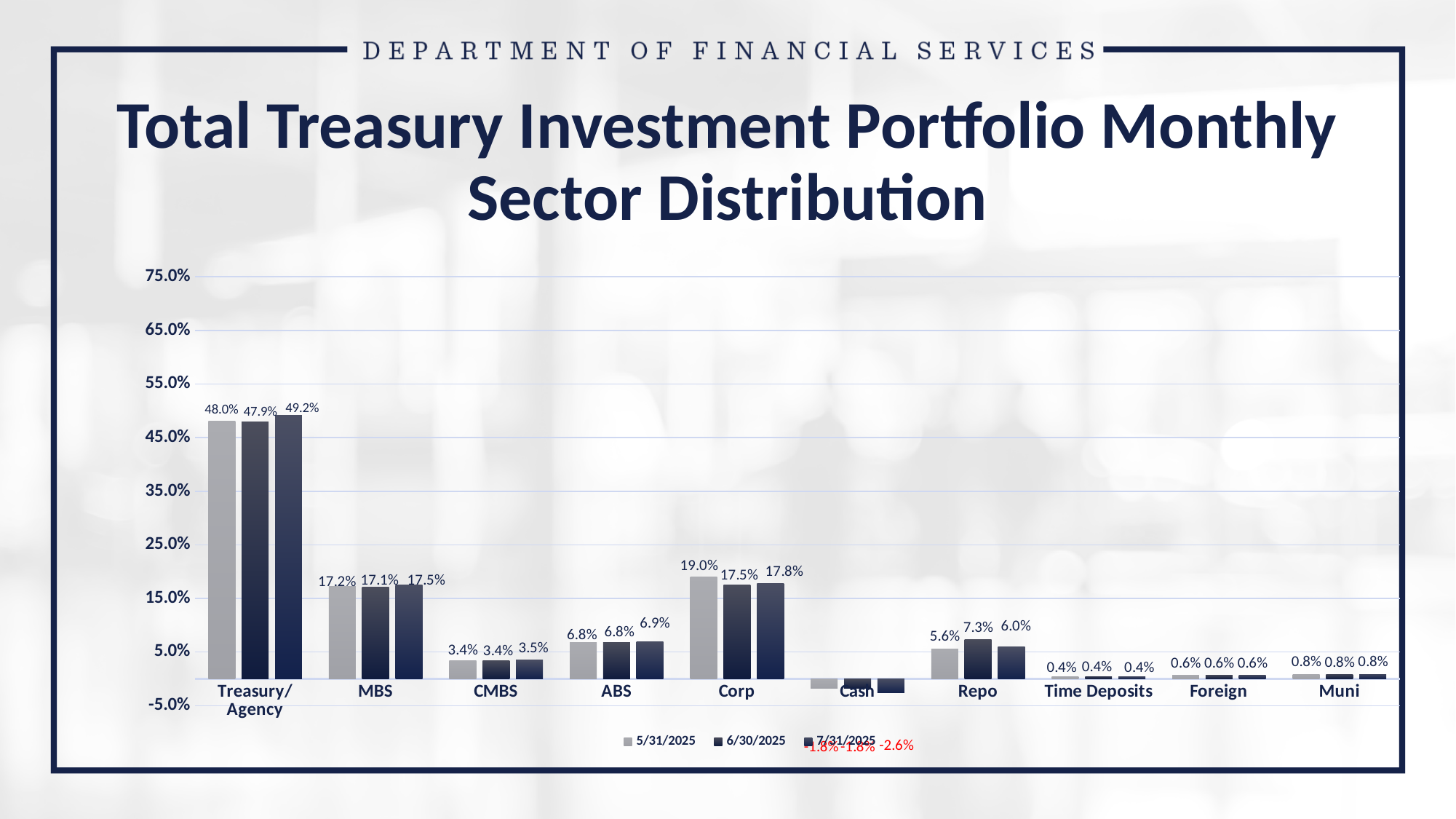
What is the title of the chart? Total Treasury Investment Portfolio Monthly Sector Distribution How many sector categories are shown on the x axis? 10 What is the value for Treasury/Agency in the 7/31/2025 series? 49.2% What is the value for Repo in the 6/30/2025 series? 7.3% Is the value for MBS in the 7/31/2025 series greater or less than 15.0%? greater What is the difference between the 7/31/2025 and 5/31/2025 values for Treasury/Agency? 1.2% How many series does the legend list? 3 Which sector has the lowest value in the 6/30/2025 series? Cash Which sector has the highest value in the 7/31/2025 series? Treasury/Agency What kind of chart is shown on the slide? Bar chart Which is larger for Corp: the 5/31/2025 value or the 7/31/2025 value? 5/31/2025 What is the value for Corp in the 5/31/2025 series? 19.0%